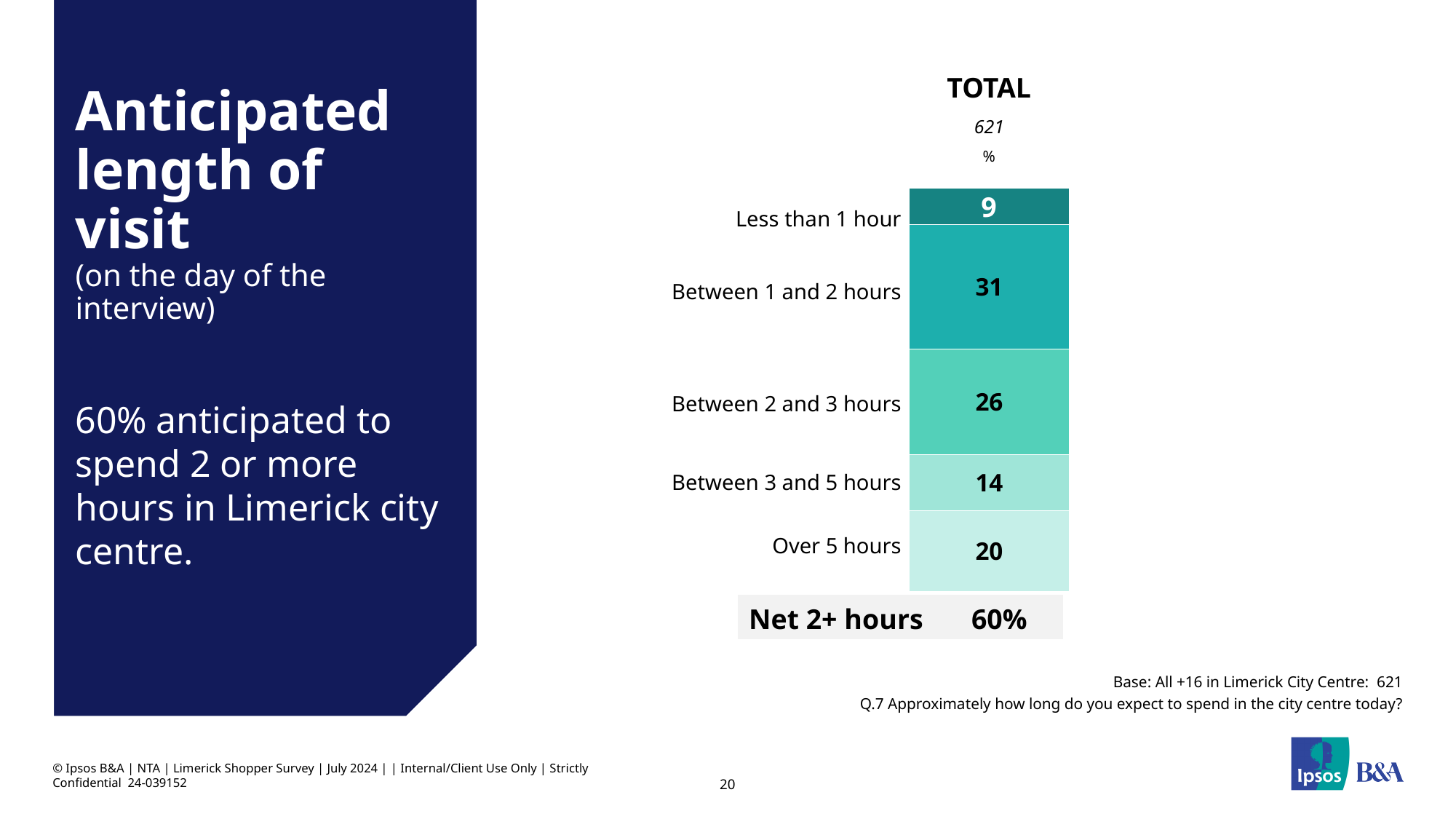
What is the value shown for 'Between 1 and 2 hours'? 31 Which is larger: the value for 'Over 5 hours' or the value for 'Between 3 and 5 hours'? Over 5 hours Which anticipated length of visit category has the highest value? Between 1 and 2 hours What kind of chart is used to show the anticipated length of visit? Stacked bar chart What is the base size shown above the bar under the 'TOTAL' heading? 621 What is the Net 2+ hours figure shown below the chart? 60% What is the value shown for 'Over 5 hours'? 20 How many length-of-visit categories are shown in the stacked bar? 5 What is the difference between the values for 'Between 1 and 2 hours' and 'Between 2 and 3 hours'? 5 What percentage of respondents anticipated spending less than 1 hour in the city centre? 9 Which anticipated length of visit category has the lowest value? Less than 1 hour What is the value shown for 'Between 3 and 5 hours'? 14